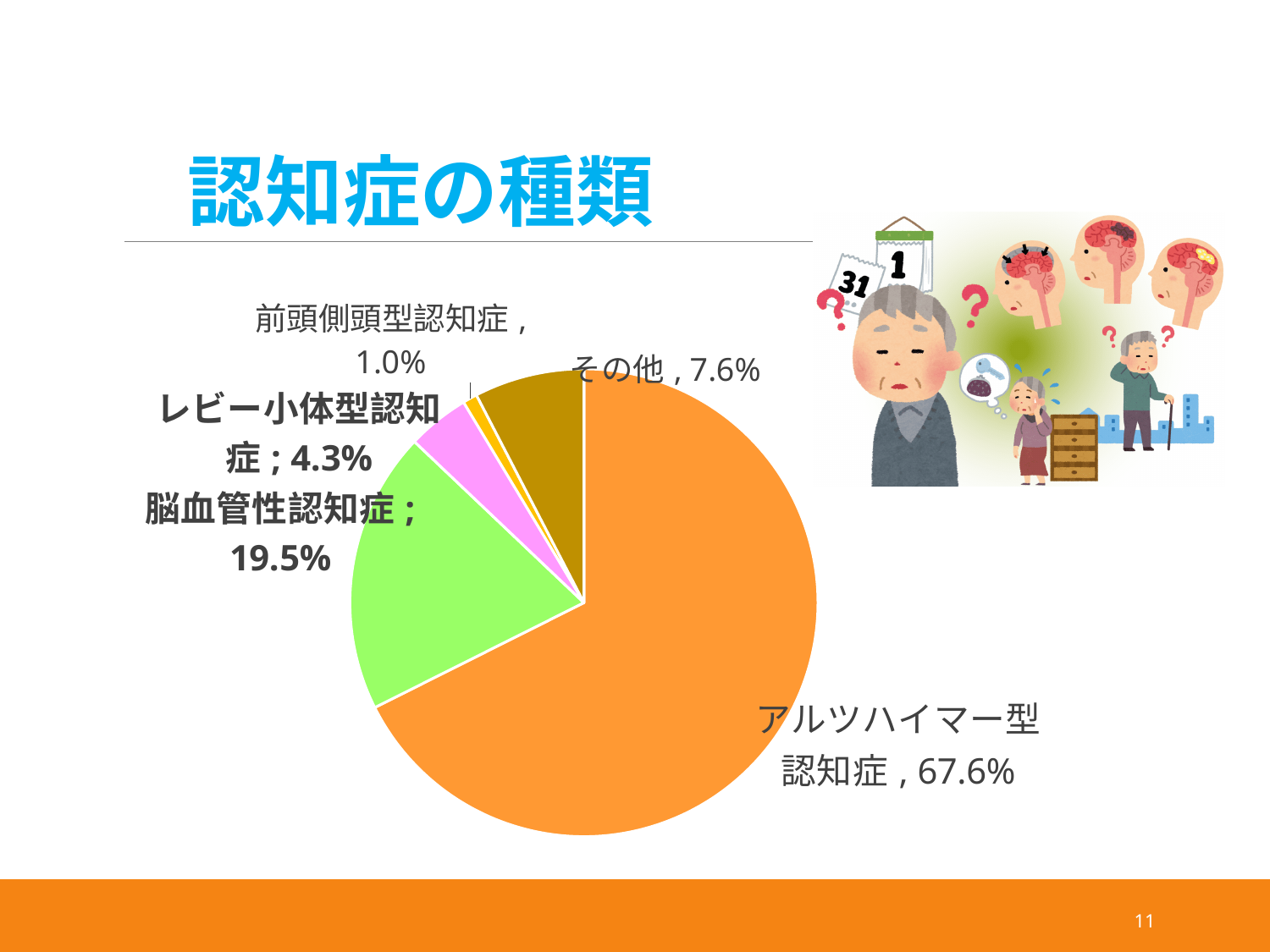
What is the value shown for 脳血管性認知症? 19.5% What is the value shown for レビー小体型認知症? 4.3% What kind of chart is shown on the slide? pie chart Which category has the largest slice of the pie? アルツハイマー型認知症 Which is larger, the value for その他 or the value for レビー小体型認知症? その他 What is the title of the slide containing the chart? 認知症の種類 Which category has the smallest slice of the pie? 前頭側頭型認知症 What share of the pie does アルツハイマー型認知症 represent? 67.6% What is the difference between the values for アルツハイマー型認知症 and 脳血管性認知症? 48.1% How many categories are shown in the pie chart? 5 What is the value shown for 前頭側頭型認知症? 1.0% What is the value shown for その他? 7.6%